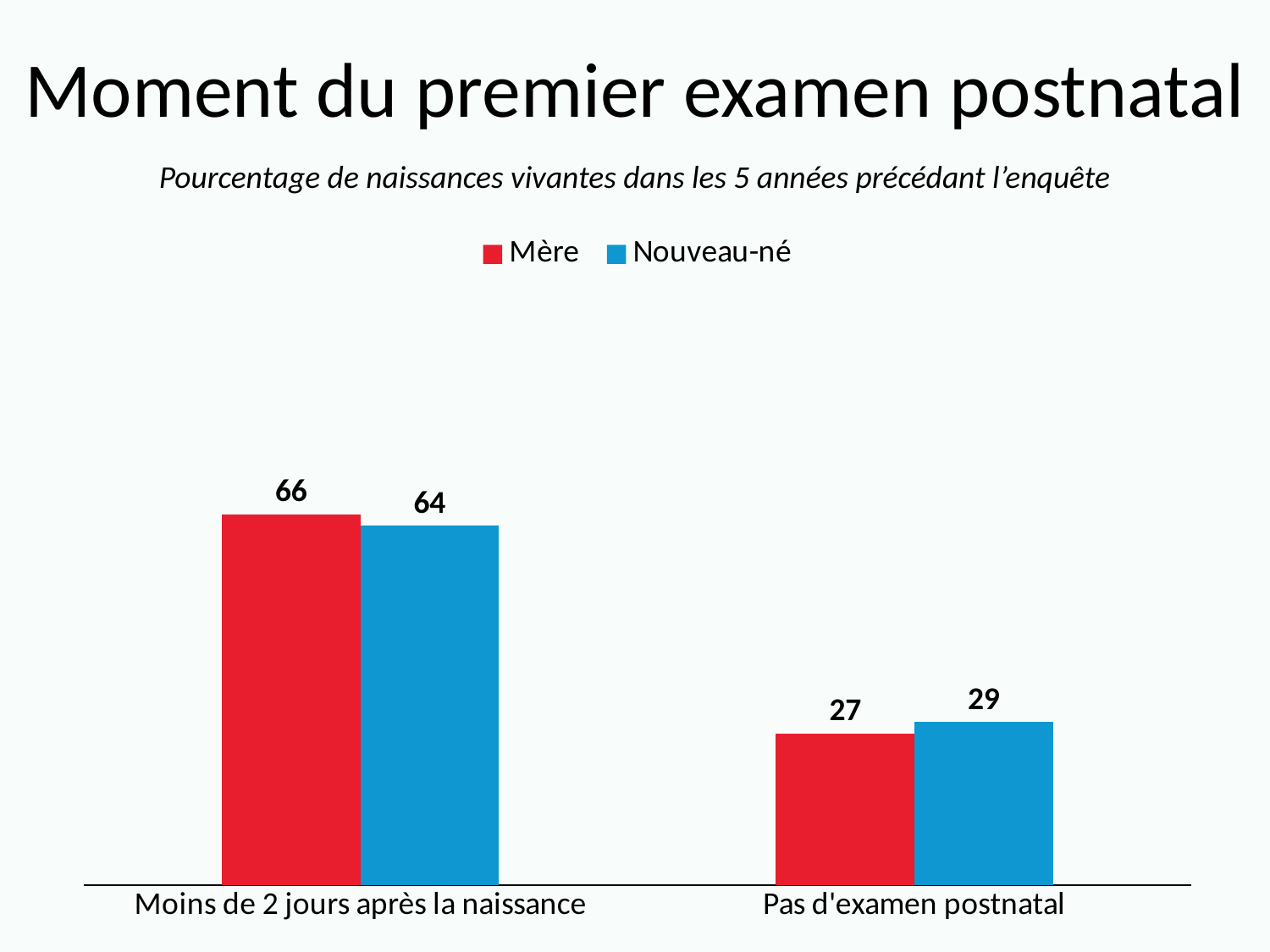
What is the difference between the Mère and Nouveau-né values for 'Moins de 2 jours après la naissance'? 2 What is the difference between the Mère values for 'Moins de 2 jours après la naissance' and 'Pas d'examen postnatal'? 39 In the 'Pas d'examen postnatal' category, which series has the larger value, Mère or Nouveau-né? Nouveau-né Which category has the highest value for Mère? Moins de 2 jours après la naissance How many categories are shown on the x axis? 2 What is the value for Nouveau-né in the 'Pas d'examen postnatal' category? 29 What is the value for Mère in the 'Moins de 2 jours après la naissance' category? 66 How many series does the legend list? 2 What is the value for Mère in the 'Pas d'examen postnatal' category? 27 Which category has the lowest value for Nouveau-né? Pas d'examen postnatal What is the value for Nouveau-né in the 'Moins de 2 jours après la naissance' category? 64 What kind of chart is shown on the slide? Bar chart